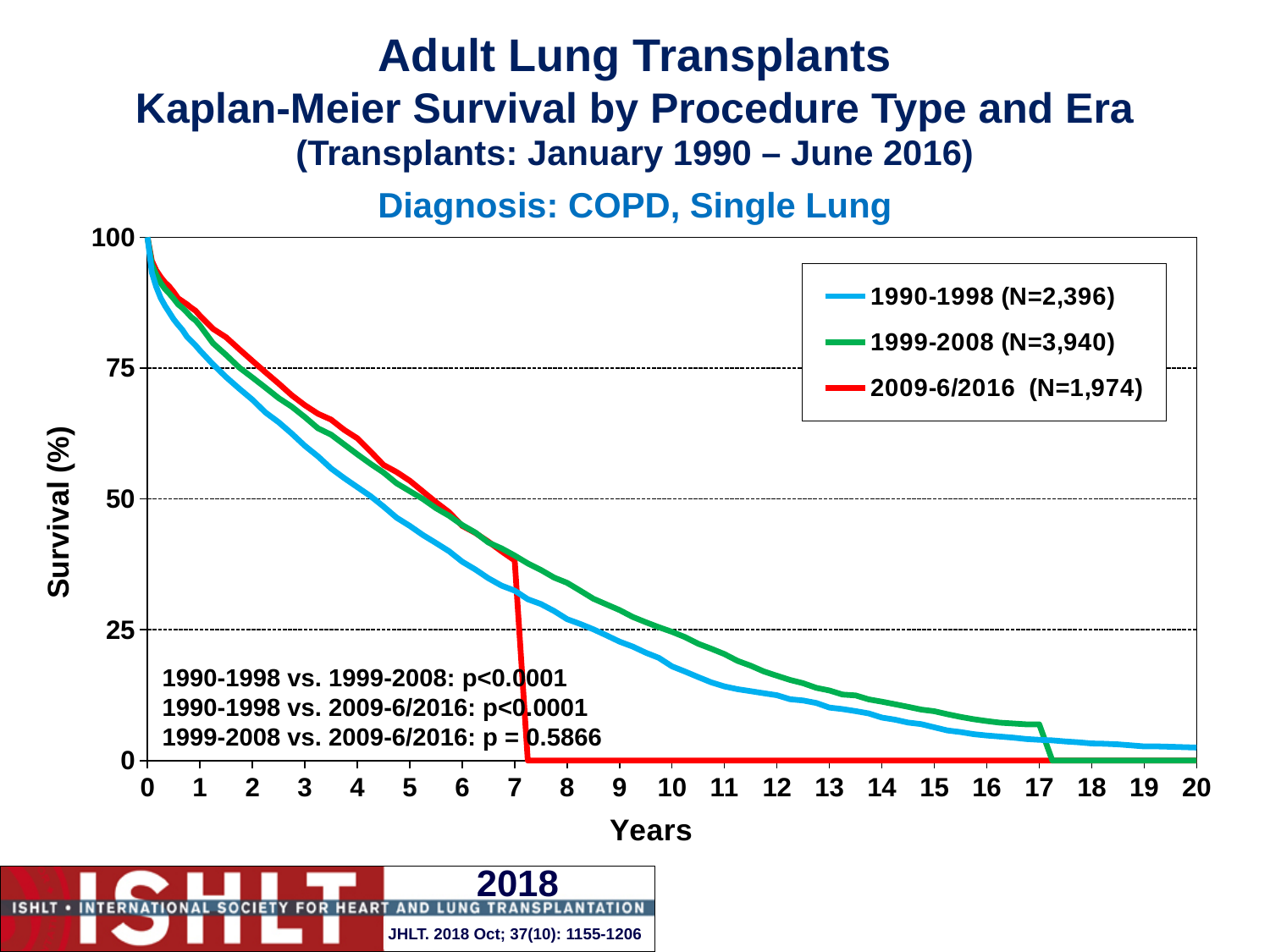
Do the survival curves rise or fall as years increase? Fall Is the survival for the 2009-6/2016 era at 3 years greater or less than 50? greater How many series does the legend list? 3 What kind of chart is shown on the slide? Line chart Is the survival for the 1990-1998 era at 5 years greater or less than 50? less What p-value is given for 1999-2008 vs. 2009-6/2016? p = 0.5866 What is the N for the 2009-6/2016 era shown in the legend? N=1,974 At 3 years, which era has higher survival: 1990-1998 or 2009-6/2016? 2009-6/2016 What is the N for the 1999-2008 era shown in the legend? N=3,940 What is the N for the 1990-1998 era shown in the legend? N=2,396 What p-value is given for 1990-1998 vs. 1999-2008? p<0.0001 Is the survival for the 1990-1998 era at 10 years greater or less than 25? less